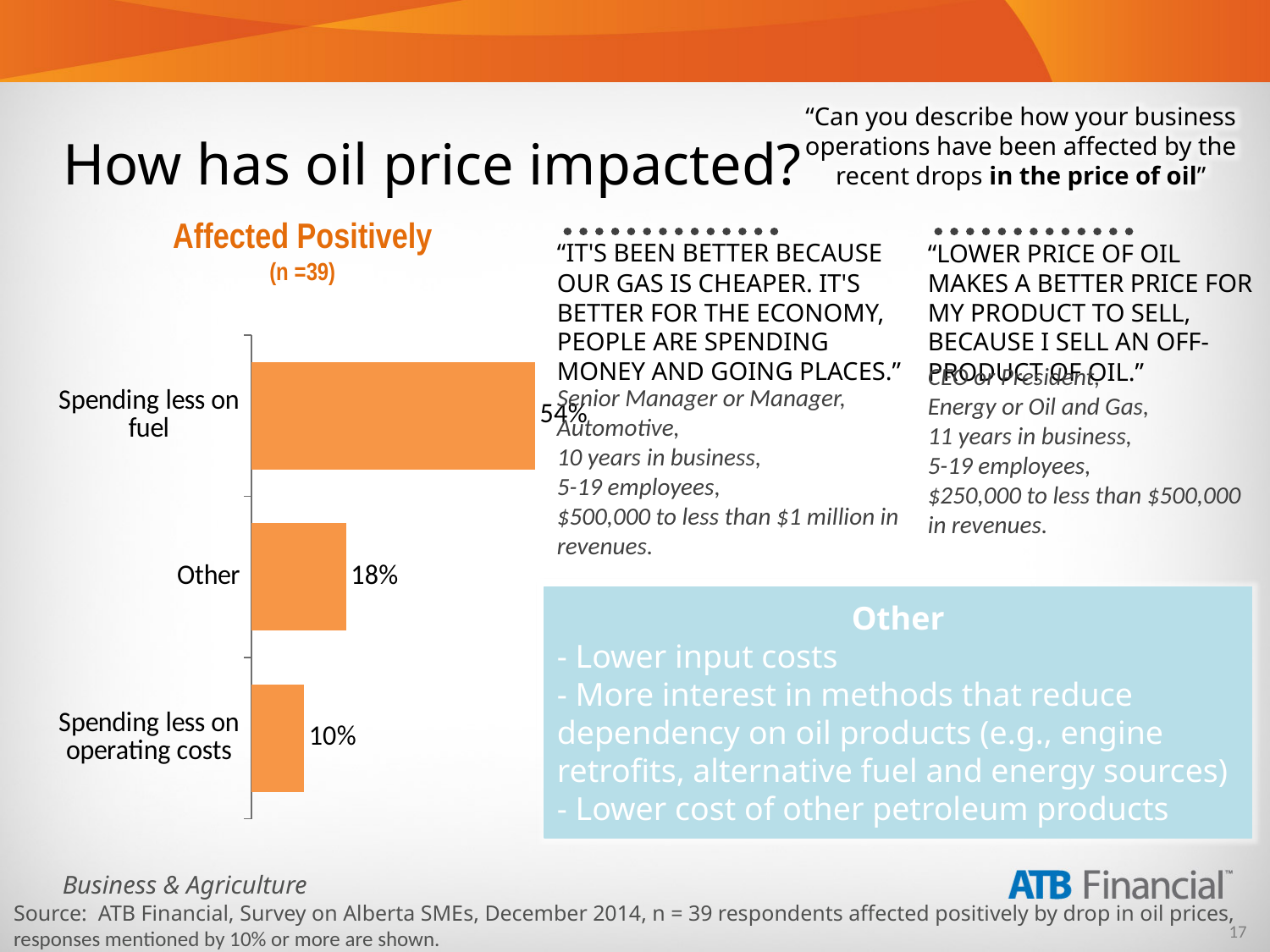
What is the difference between "Spending less on fuel" and "Other" in the Affected Positively chart? 36% What is the value for "Spending less on fuel" in the Affected Positively chart? 54% Which is larger in the Affected Positively chart: "Other" or "Spending less on operating costs"? Other Which category has the highest value in the Affected Positively chart? Spending less on fuel What sample size (n) is shown under the chart title? n =39 Which category has the lowest value in the Affected Positively chart? Spending less on operating costs How many categories are shown in the Affected Positively chart? 3 What is the title of the chart on the slide? Affected Positively What kind of chart is the Affected Positively chart? Bar chart What is the value for "Spending less on operating costs" in the Affected Positively chart? 10% What is the difference between "Other" and "Spending less on operating costs" in the Affected Positively chart? 8% What is the value for "Other" in the Affected Positively chart? 18%